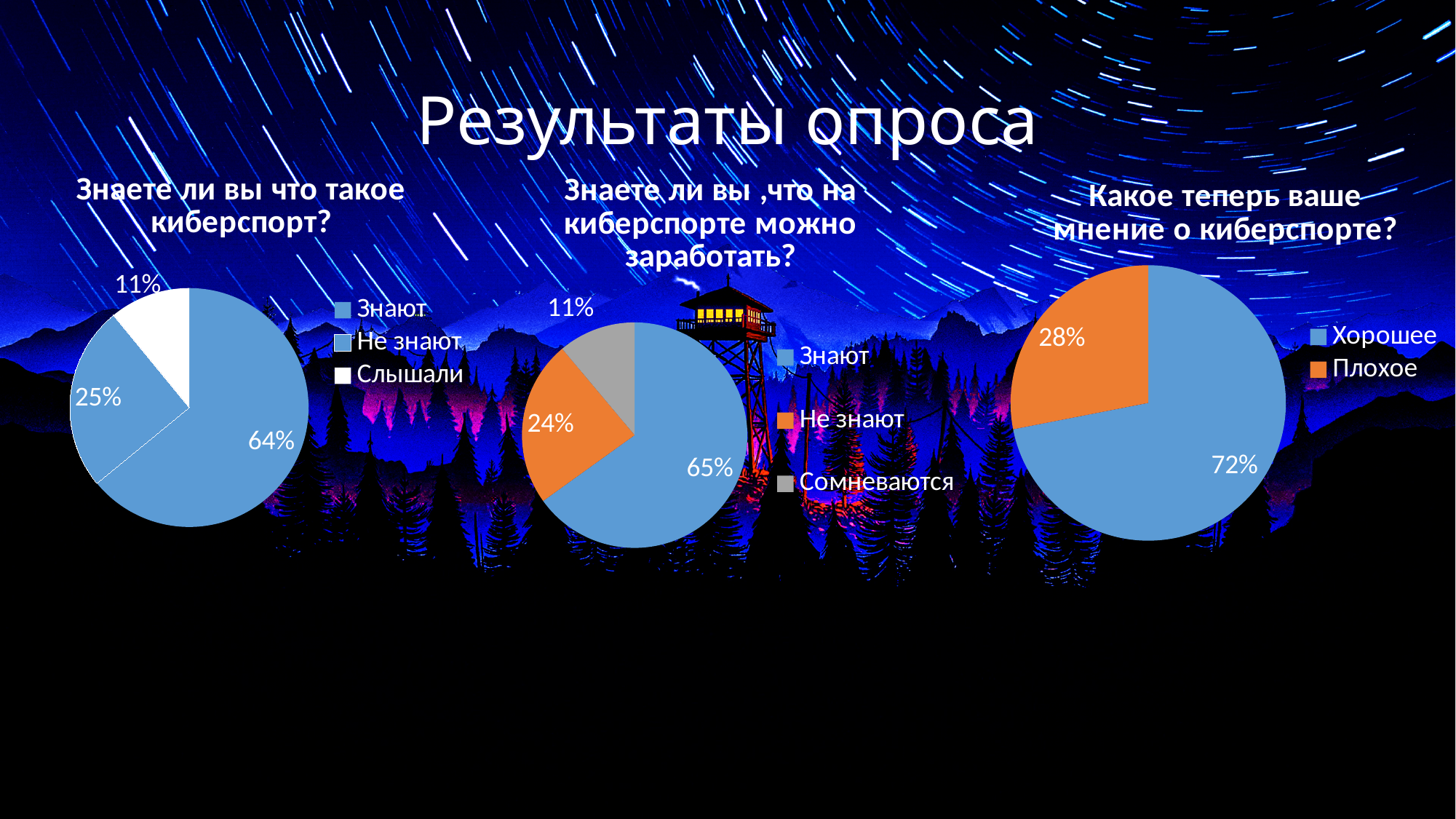
What type of chart is used for the right chart 'Какое теперь ваше мнение о киберспорте?'? Pie chart In the right chart 'Какое теперь ваше мнение о киберспорте?', which is larger, 'Хорошее' or 'Плохое'? Хорошее In the left chart 'Знаете ли вы что такое киберспорт?', what share is labelled for 'Слышали'? 11% In the right chart 'Какое теперь ваше мнение о киберспорте?', what is the difference between the 'Хорошее' and 'Плохое' shares? 44% In the left chart 'Знаете ли вы что такое киберспорт?', how many slices does the pie have? 3 In the middle chart 'Знаете ли вы, что на киберспорте можно заработать?', what share is labelled for 'Не знают'? 24% In the middle chart 'Знаете ли вы, что на киберспорте можно заработать?', what is the difference between the 'Знают' and 'Не знают' shares? 41% In the middle chart 'Знаете ли вы, что на киберспорте можно заработать?', which category has the largest slice? Знают In the left chart 'Знаете ли вы что такое киберспорт?', which category has the smallest slice? Слышали In the right chart 'Какое теперь ваше мнение о киберспорте?', what share is labelled for 'Плохое'? 28% In the middle chart 'Знаете ли вы, что на киберспорте можно заработать?', how many entries does the legend list? 3 In the left chart 'Знаете ли вы что такое киберспорт?', what share is labelled for 'Знают'? 64%